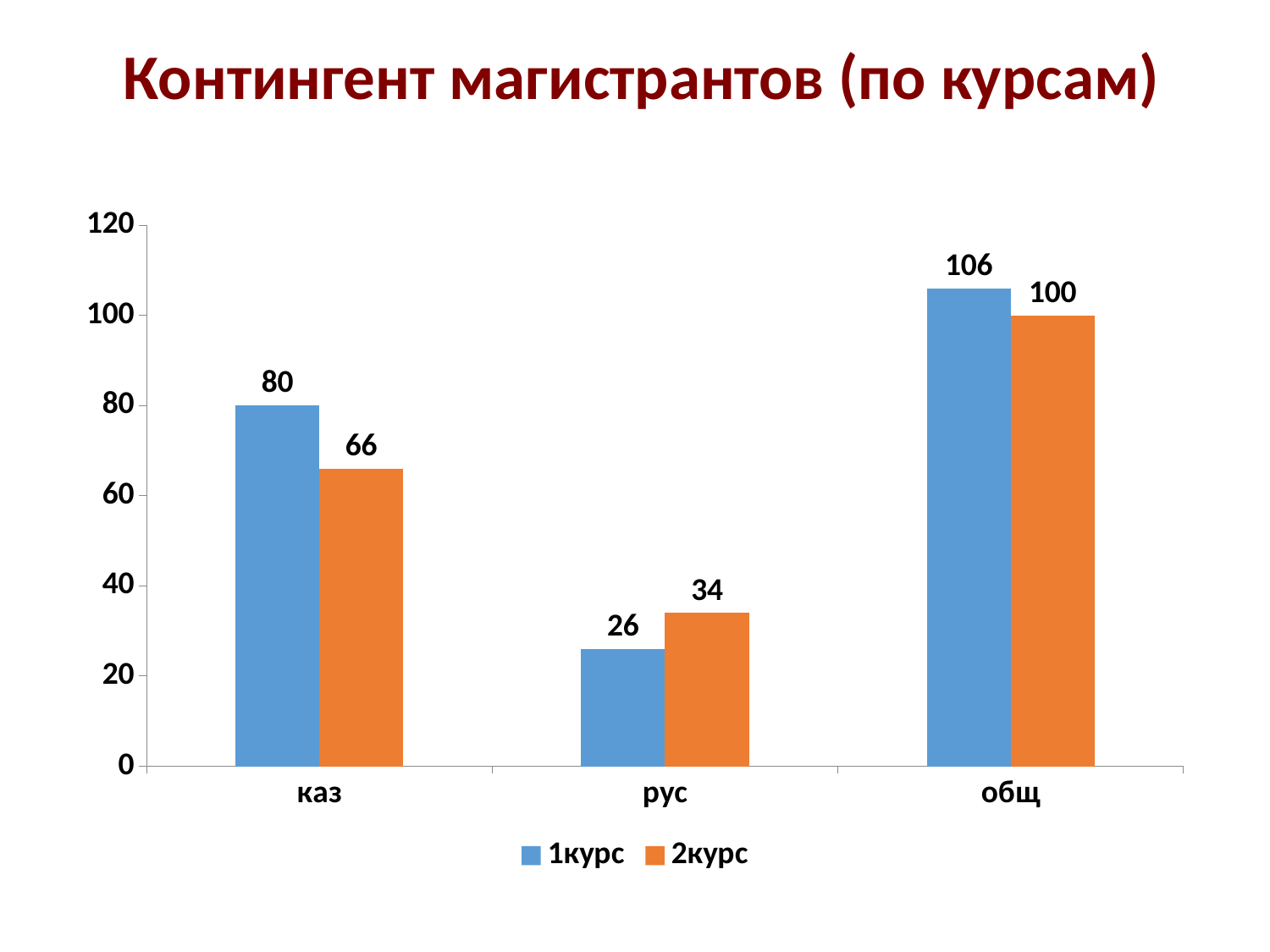
What is the difference between 1курс and 2курс in the общ category? 6 Which category has the highest value for 1курс? общ What is the difference between 1курс and 2курс in the каз category? 14 What is the value for 2курс in the общ category? 100 What kind of chart is shown on the slide? bar chart Which category has the lowest value for 2курс? рус What is the value for 2курс in the рус category? 34 How many categories are shown on the x axis? 3 In the рус category, which series has the larger value, 1курс or 2курс? 2курс What is the value for 1курс in the каз category? 80 Is the value for 1курс in the общ category greater or less than 100? greater How many series does the legend list? 2